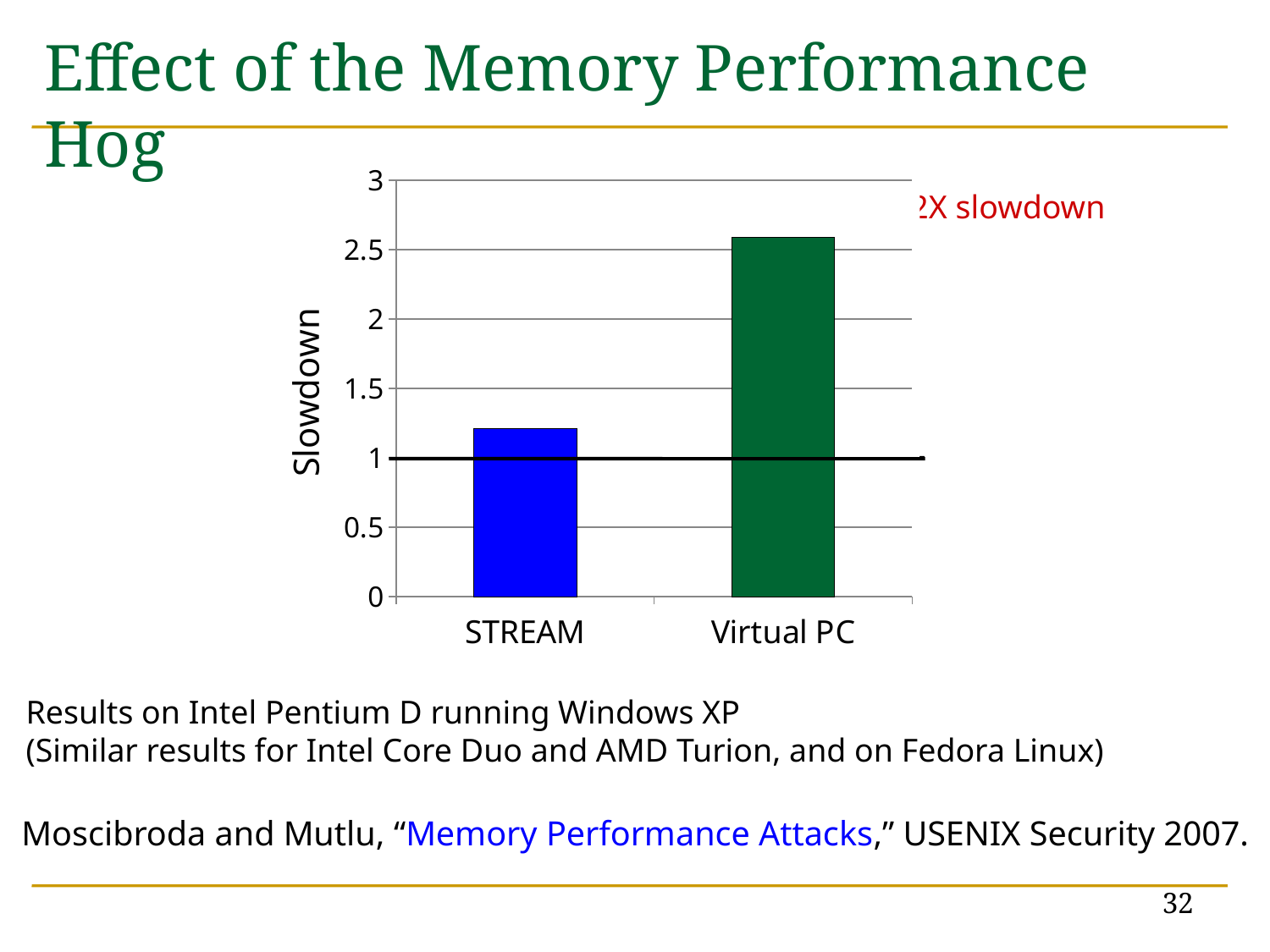
What kind of chart is shown on the slide? bar chart Do the bar values rise or fall going from STREAM to Virtual PC? rise Is the slowdown for Virtual PC greater or less than 2? greater What colour is the bar for Virtual PC? green Is the slowdown for STREAM greater or less than 1? greater How many categories are plotted on the x axis of the chart? 2 Is the slowdown for STREAM greater or less than 1.5? less Which category has the lowest slowdown in the chart? STREAM Which category has the highest slowdown in the chart? Virtual PC What is the label on the y axis of the chart? Slowdown Which has the larger slowdown, STREAM or Virtual PC? Virtual PC